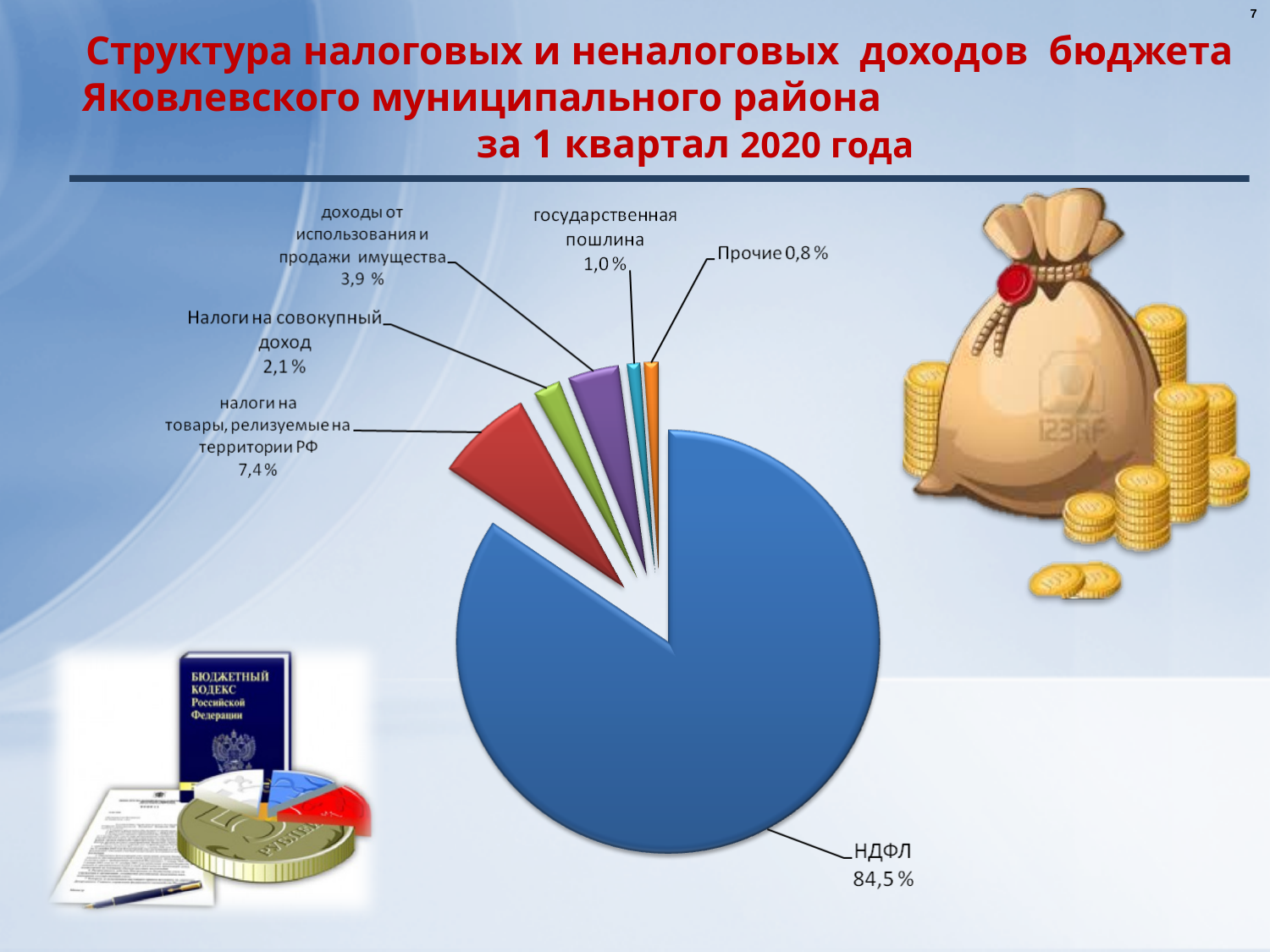
Which category has the smallest slice of the pie? Прочие What is the value shown for налоги на товары, реализуемые на территории РФ? 7,4 % What kind of chart is shown on the slide? pie chart Which is larger: доходы от использования и продажи имущества or Налоги на совокупный доход? доходы от использования и продажи имущества What is the value shown for доходы от использования и продажи имущества? 3,9 % What is the difference in percentage points between НДФЛ and налоги на товары, реализуемые на территории РФ? 77,1 What share of the pie does НДФЛ account for? 84,5 % How many slices does the pie chart have? 6 Which category has the largest slice of the pie? НДФЛ What is the value shown for Налоги на совокупный доход? 2,1 % What is the value shown for государственная пошлина? 1,0 % What is the value shown for Прочие? 0,8 %